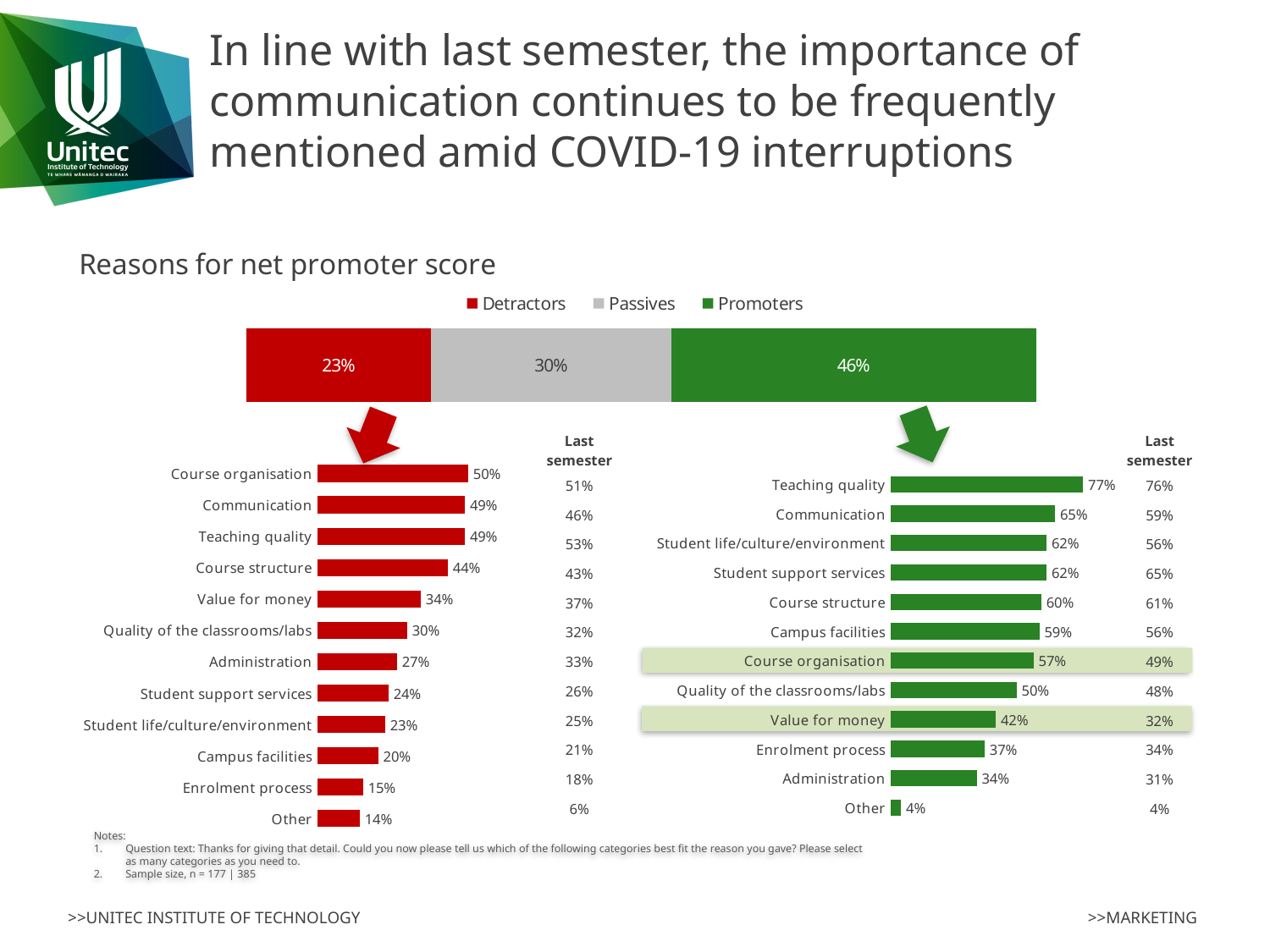
What kind of chart is the left (red, Detractors) chart? Bar chart In the right (green, Promoters) bar chart, what is the difference between Teaching quality and Administration? 43% In the left (red, Detractors) bar chart, how many categories are shown? 12 In the right (green, Promoters) bar chart, what is the value for Value for money? 42% In the stacked bar at the top of the slide, what percentage are Passives? 30% In the left (red, Detractors) bar chart, which category has the lowest value? Other In the left (red, Detractors) bar chart, what is the value for Course organisation? 50% How many series does the legend of the stacked bar at the top of the slide list? 3 In the stacked bar at the top of the slide, what percentage are Promoters? 46% In the right (green, Promoters) bar chart, which is larger: Communication or Course structure? Communication In the left (red, Detractors) bar chart, what is the difference between Course organisation and Enrolment process? 35% In the right (green, Promoters) bar chart, which category has the highest value? Teaching quality